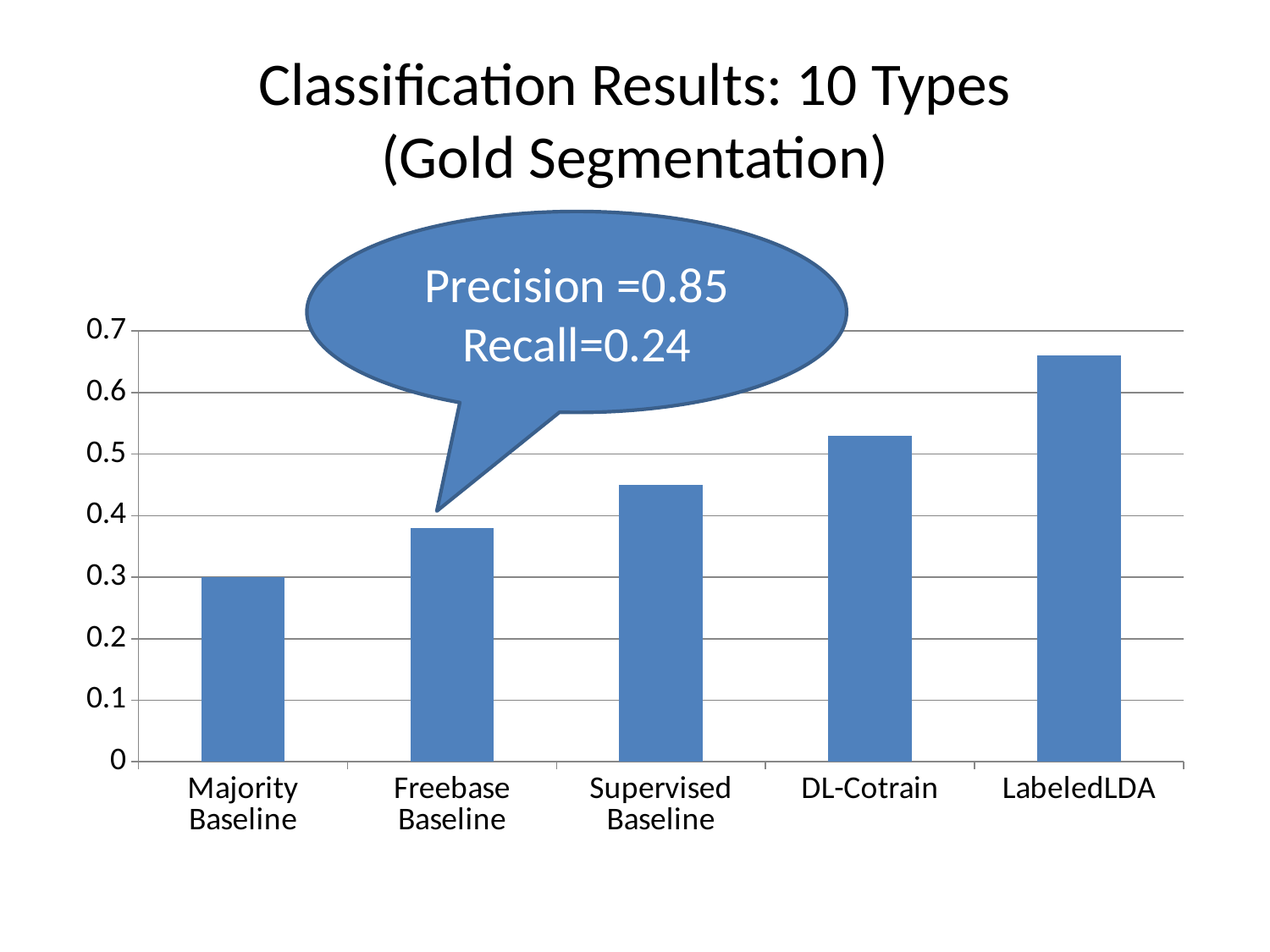
What is the value for Majority Baseline in the chart? 0.3 How many categories are shown on the x axis of the chart? 5 Which category has the highest bar in the chart? LabeledLDA Is the value for Freebase Baseline greater or less than 0.4? less Which category has the lowest bar in the chart? Majority Baseline What type of chart is shown on the slide? bar chart What is the title of the chart on the slide? Classification Results: 10 Types (Gold Segmentation) Is the value for Supervised Baseline greater or less than 0.5? less Do the bar values rise or fall from left to right along the x axis? rise Is the value for LabeledLDA greater or less than 0.6? greater Which is larger, the value for DL-Cotrain or the value for Supervised Baseline? DL-Cotrain